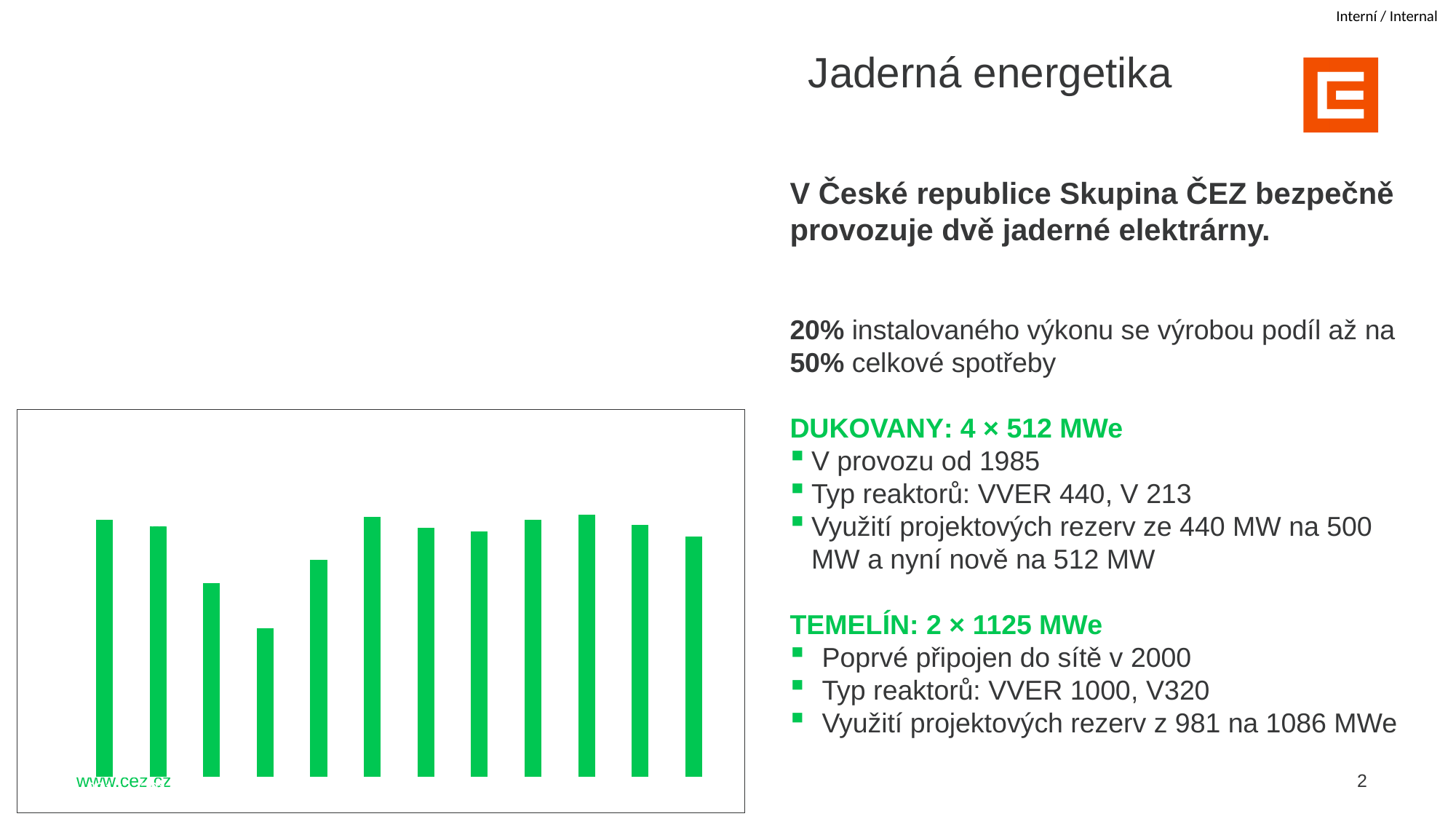
In the chart, is the 4th bar from the left taller or shorter than the 1st bar? shorter In the chart, is the 5th bar from the left taller or shorter than the 7th bar? shorter What colour are the bars in the chart? green What kind of chart is shown on the left of the slide? bar chart In the chart, is the 3rd bar from the left taller or shorter than the 4th bar? taller Does the chart on the slide display a legend? No Counting from the left, which bar in the chart is the shortest? the 4th bar How many bars does the chart on the left of the slide contain? 12